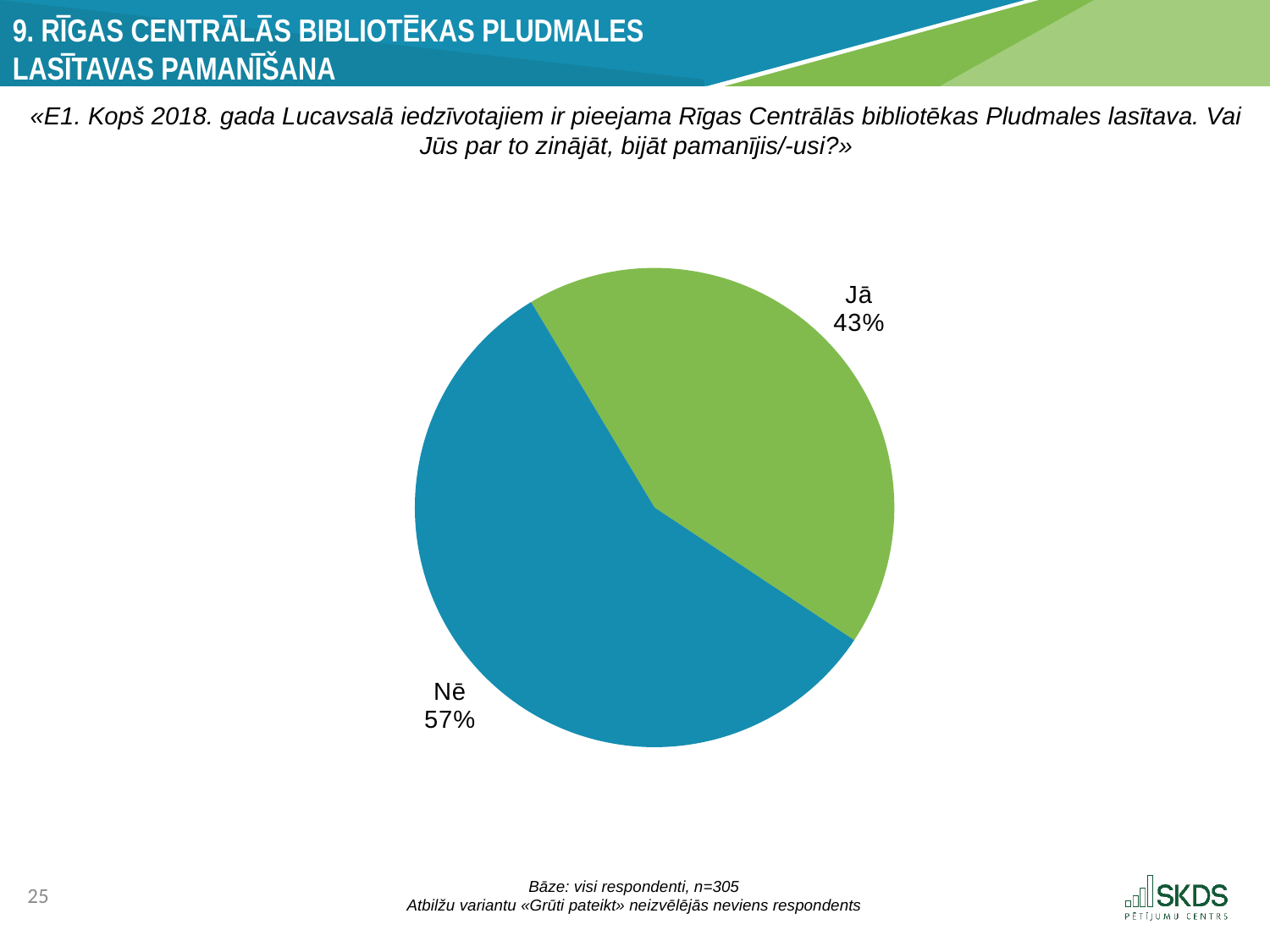
What colour is the "Jā" slice? green What is the difference in percentage points between the "Nē" and "Jā" slices? 14 Which answer has the largest share of the pie? Nē What colour is the "Nē" slice? blue What share of respondents answered "Nē"? 57% Which answer has the smallest share of the pie? Jā How many slices does the pie chart have? 2 What is the total of the two slices shown in the pie chart? 100% What share of respondents answered "Jā"? 43% Which is larger, the share for "Jā" or the share for "Nē"? Nē Is the share for "Jā" greater or less than 50%? less What kind of chart is shown on the slide? pie chart